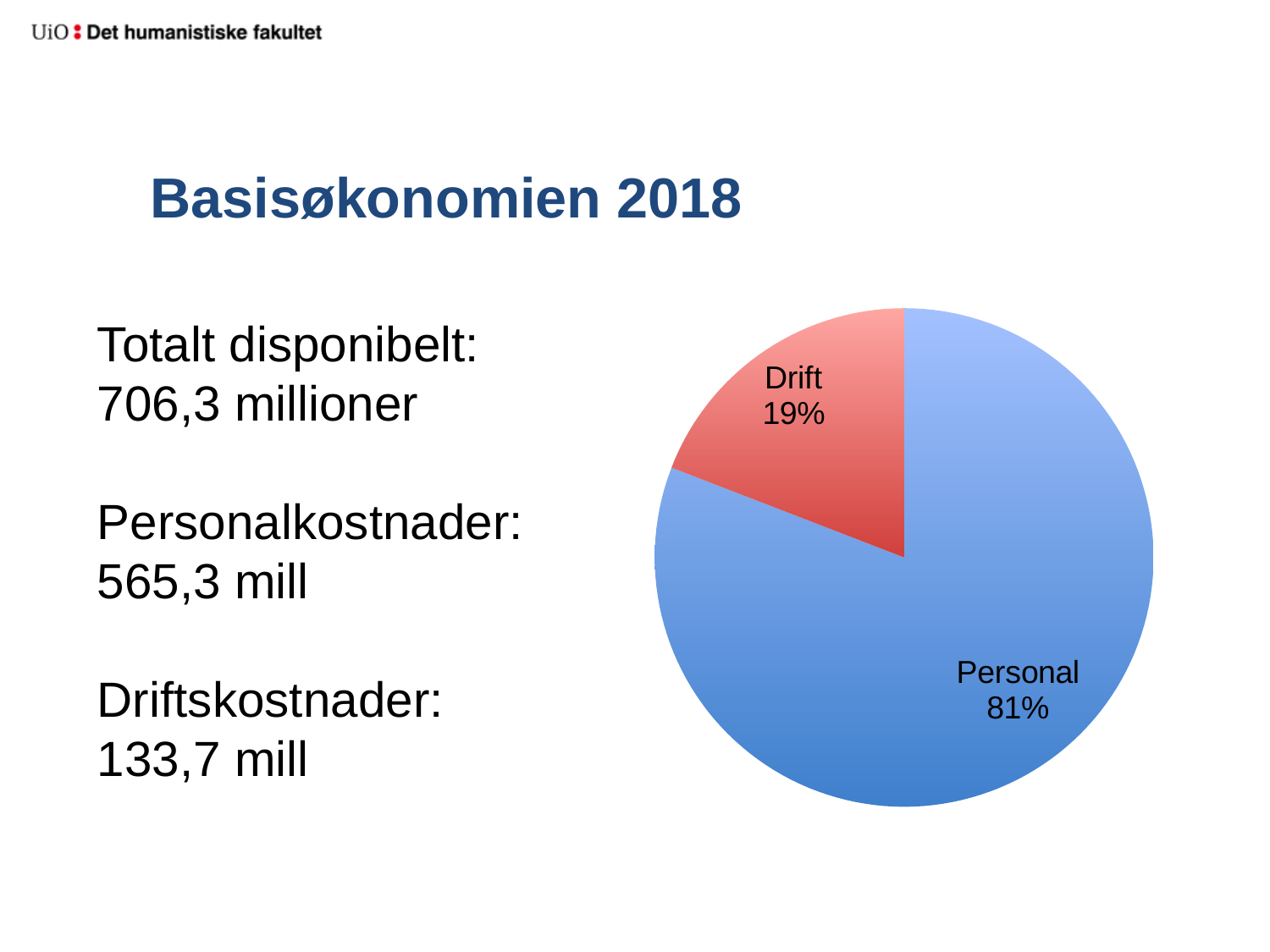
What colour is the Personal slice? blue What kind of chart is shown on the slide? pie chart What share of the pie does Drift represent? 19% Which slice of the pie is the smallest? Drift What share of the pie does Personal represent? 81% How many slices does the pie chart have? 2 Which is larger, the Personal slice or the Drift slice? Personal What is the difference in percentage points between the Personal and Drift slices? 62 What colour is the Drift slice? red Which slice of the pie is the largest? Personal